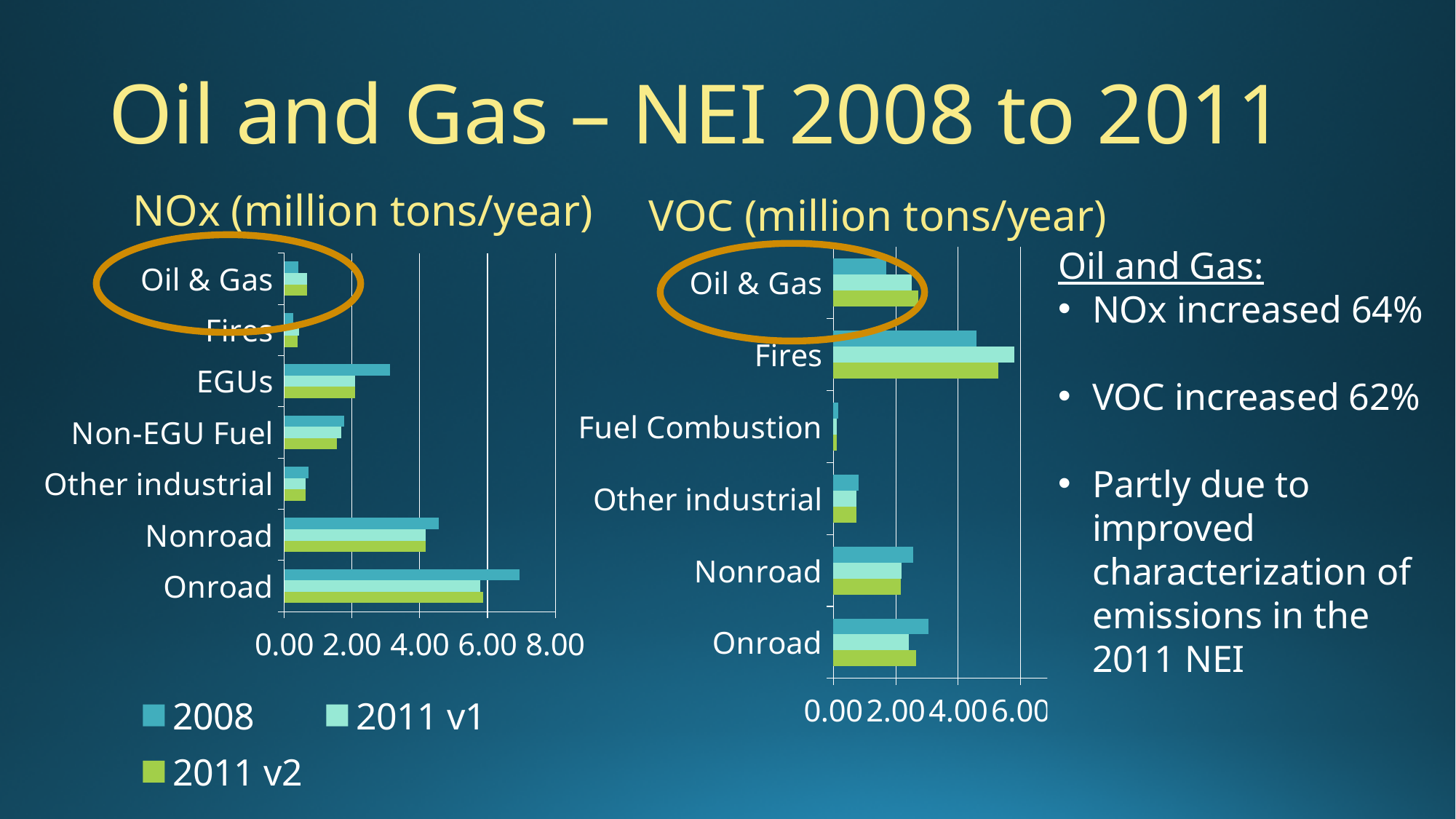
In the VOC (million tons/year) chart, is the 2011 v1 value for Fires greater or less than 4.00? greater How many series does the legend list for the charts? 3 In the NOx (million tons/year) chart, which category has the highest value? Onroad How many categories are shown on the NOx (million tons/year) chart? 7 In the NOx (million tons/year) chart, which is larger for EGUs: the 2008 value or the 2011 v2 value? 2008 In the NOx (million tons/year) chart, is the 2008 value for Onroad greater or less than 6.00? greater What kind of chart is the NOx (million tons/year) chart? bar chart In the NOx (million tons/year) chart, is the 2008 value for Oil & Gas greater or less than 2.00? less What are the three series listed in the legend? 2008, 2011 v1, 2011 v2 In the VOC (million tons/year) chart, which category has the highest value? Fires In the VOC (million tons/year) chart, which category has the lowest values? Fuel Combustion How many categories are shown on the VOC (million tons/year) chart? 6